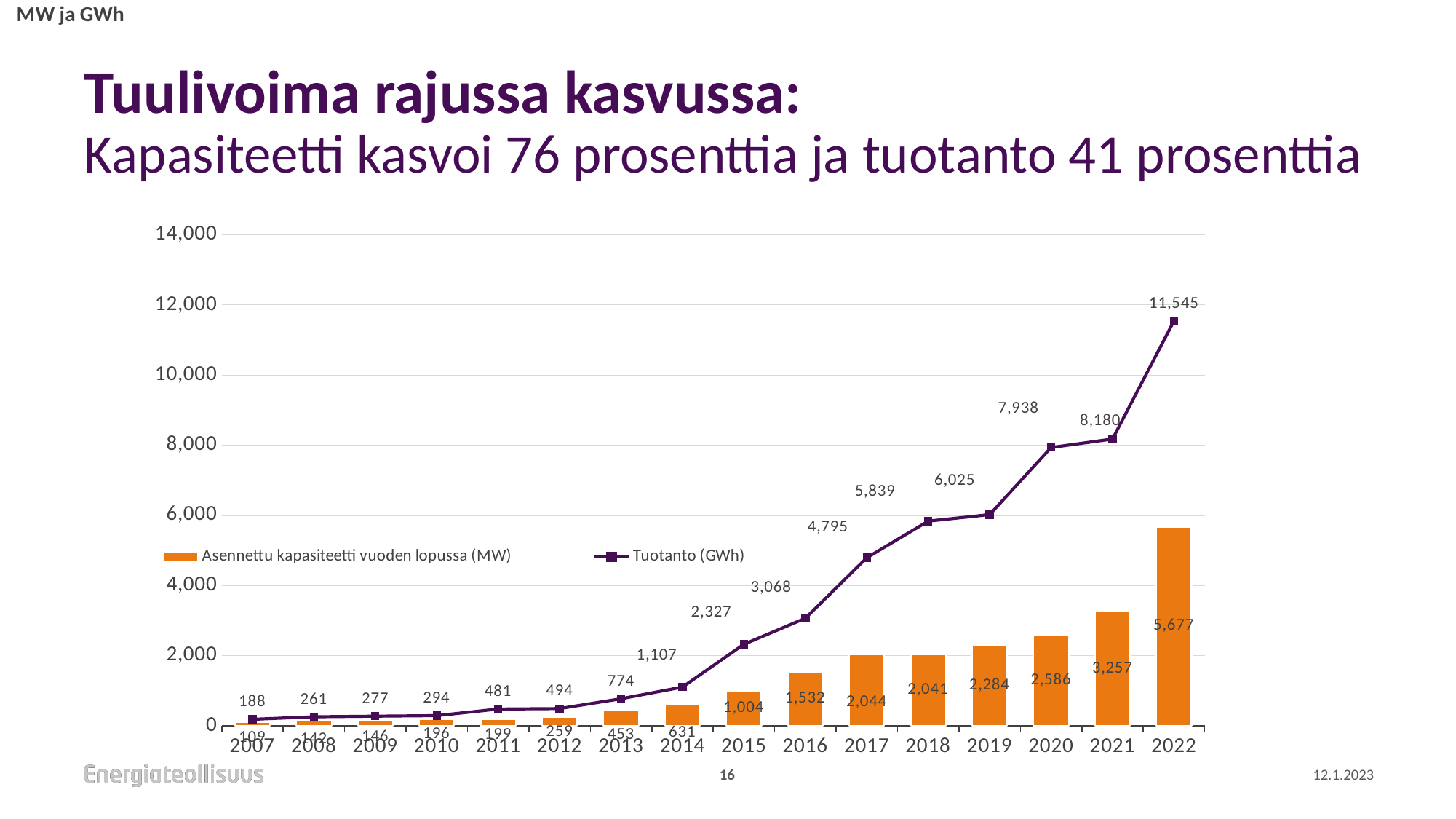
What was the production (Tuotanto, GWh) in 2014? 1,107 What is the difference in installed capacity (MW) between 2021 and 2020? 671 What is the overall trend of production (Tuotanto, GWh) from 2007 to 2022? rising How many series does the chart legend list? 2 What was the installed capacity at year end (Asennettu kapasiteetti vuoden lopussa, MW) in 2022? 5,677 Which year had higher installed capacity (MW): 2017 or 2018? 2017 What was the production (Tuotanto, GWh) in 2019? 6,025 In which year was installed capacity (MW) lowest? 2007 How many years are shown on the x axis of the chart? 16 By how much did production (GWh) increase from 2021 to 2022? 3,365 In which year was production (Tuotanto, GWh) highest? 2022 Is the production (GWh) value for 2020 greater or less than 8,000? less